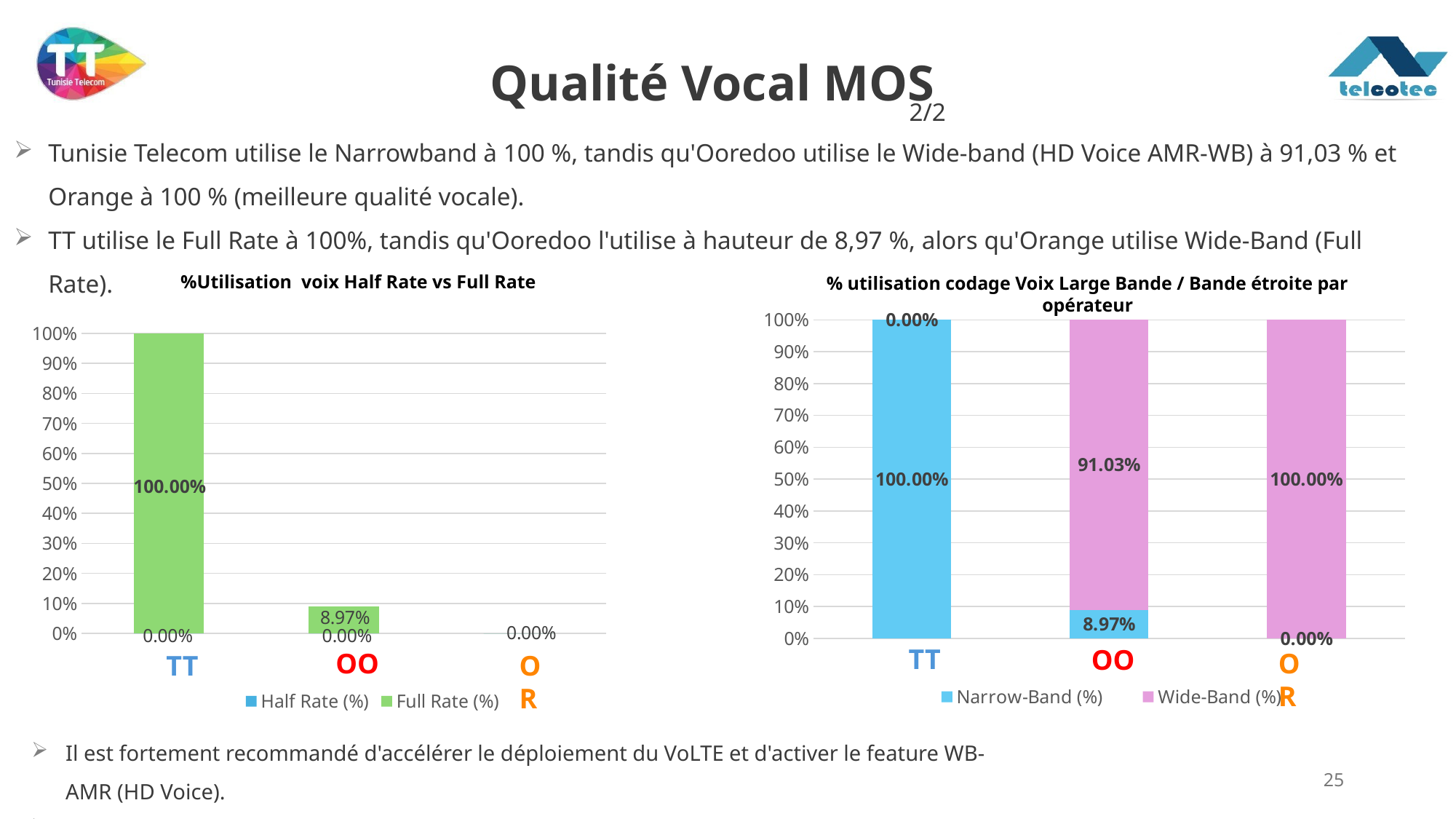
In the chart '%Utilisation voix Half Rate vs Full Rate', what type of chart is shown? Bar chart In the chart '% utilisation codage Voix Large Bande / Bande étroite par opérateur', what is the Wide-Band (%) value for OO? 91.03% In the chart '%Utilisation voix Half Rate vs Full Rate', what is the Full Rate (%) value for TT? 100.00% In the chart '%Utilisation voix Half Rate vs Full Rate', how many series does the legend list? 2 In the chart '% utilisation codage Voix Large Bande / Bande étroite par opérateur', what is the Narrow-Band (%) value for OO? 8.97% In the chart '% utilisation codage Voix Large Bande / Bande étroite par opérateur', what is the Wide-Band (%) value for OR? 100.00% In the chart '% utilisation codage Voix Large Bande / Bande étroite par opérateur', which operator has the highest Narrow-Band (%) value? TT In the chart '% utilisation codage Voix Large Bande / Bande étroite par opérateur', how many operators are shown on the x axis? 3 In the chart '%Utilisation voix Half Rate vs Full Rate', what is the Full Rate (%) value for OO? 8.97% In the chart '% utilisation codage Voix Large Bande / Bande étroite par opérateur', what is the difference between the Wide-Band (%) and Narrow-Band (%) values for OO? 82.06% In the chart '%Utilisation voix Half Rate vs Full Rate', which operator has the highest Full Rate (%) value? TT In the chart '% utilisation codage Voix Large Bande / Bande étroite par opérateur', what is the Narrow-Band (%) value for TT? 100.00%